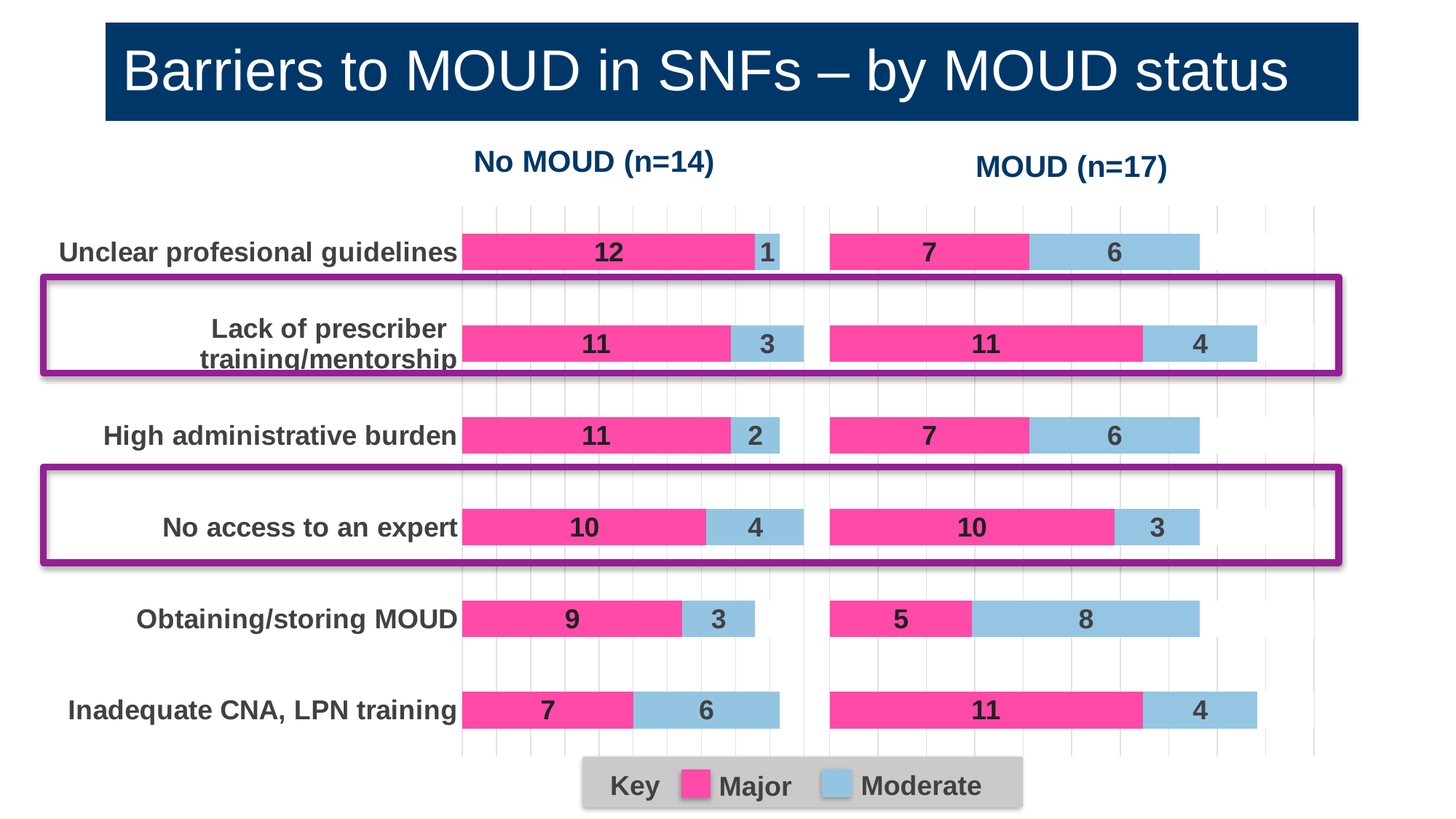
In the MOUD (n=17) chart, which category has the lowest Major value? Obtaining/storing MOUD In the No MOUD (n=14) chart, is the Major value for Obtaining/storing MOUD larger or smaller than the Major value for Inadequate CNA, LPN training? larger In the MOUD (n=17) chart, what is the Major value for Inadequate CNA, LPN training? 11 In the No MOUD (n=14) chart, which category has the highest Major value? Unclear profesional guidelines In the No MOUD (n=14) chart, what is the total of the stacked bar for No access to an expert? 14 What kind of chart is the MOUD (n=17) chart? stacked bar chart In the No MOUD (n=14) chart, what is the Major value for Unclear profesional guidelines? 12 In the MOUD (n=17) chart, what is the total of the stacked bar for Lack of prescriber training/mentorship? 15 In the MOUD (n=17) chart, what is the Moderate value for Obtaining/storing MOUD? 8 How many series does the key list? 2 How many categories are shown in the No MOUD (n=14) chart? 6 What is the difference between the Major value for High administrative burden in the No MOUD (n=14) chart and in the MOUD (n=17) chart? 4